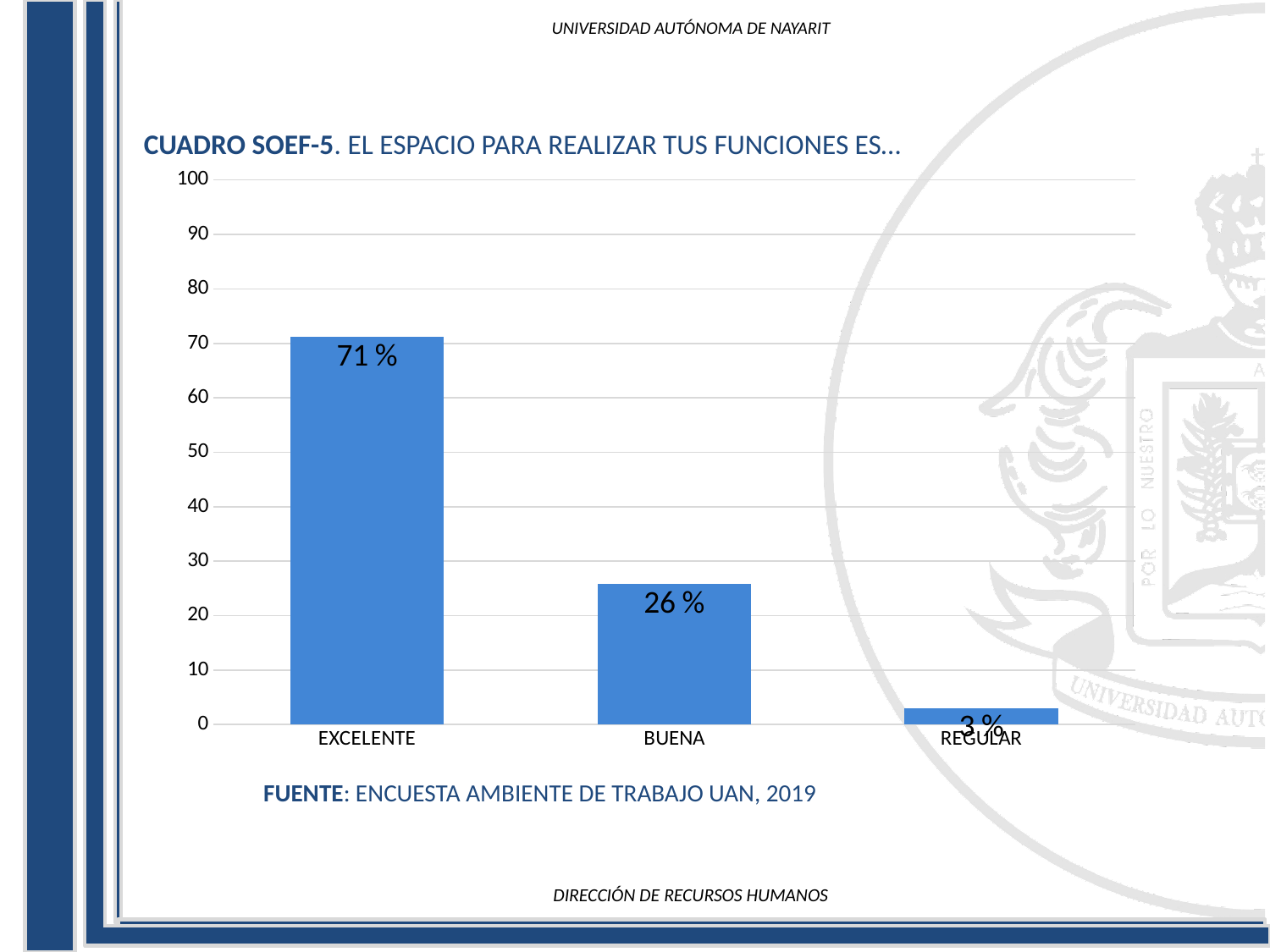
Which category has the highest value? EXCELENTE Is the value for EXCELENTE greater or less than 60? greater What kind of chart is shown on the slide? bar chart Which category has the lowest value? REGULAR What is the value for REGULAR? 3 % Do the values rise or fall from left to right along the x axis? fall How many categories are shown on the x axis? 3 What is the difference between the values for EXCELENTE and BUENA? 45 % What is the value for BUENA? 26 % What is the difference between the values for BUENA and REGULAR? 23 % Which is larger, the value for BUENA or the value for REGULAR? BUENA What is the value for EXCELENTE? 71 %